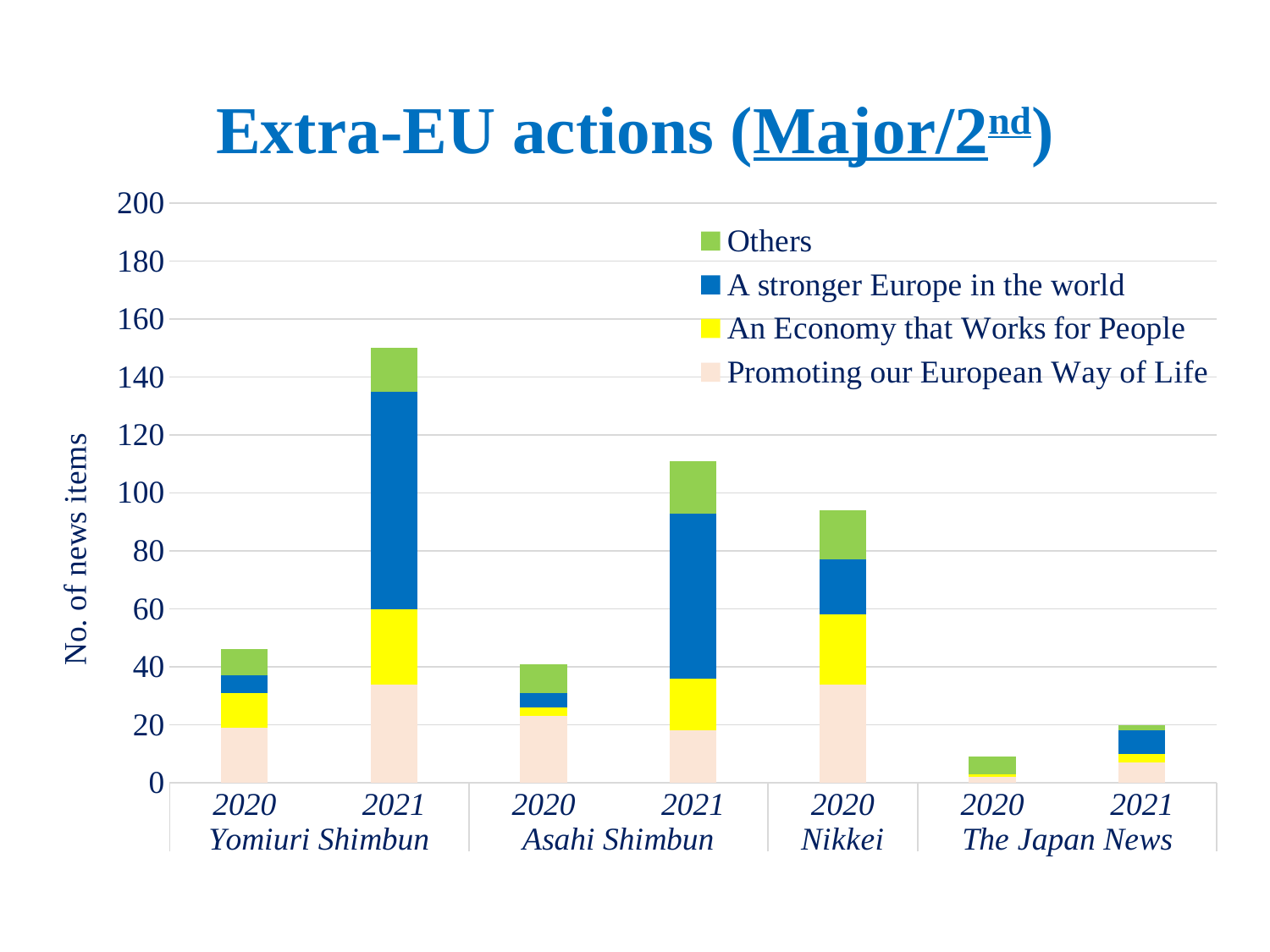
How many series does the legend list? 4 Which has a larger total, Nikkei 2020 or Yomiuri Shimbun 2020? Nikkei 2020 Is the total for Asahi Shimbun 2020 greater or less than 60? less Which bar has the highest total number of news items? Yomiuri Shimbun 2021 Is the total for The Japan News 2020 greater or less than 20? less Which bar has the lowest total number of news items? The Japan News 2020 Which has a larger total, Yomiuri Shimbun 2021 or Asahi Shimbun 2021? Yomiuri Shimbun 2021 Is the total for Yomiuri Shimbun 2021 greater or less than 140? greater What kind of chart is shown on the slide? Stacked bar chart How many bars are plotted in the chart? 7 What is the label on the vertical axis? No. of news items